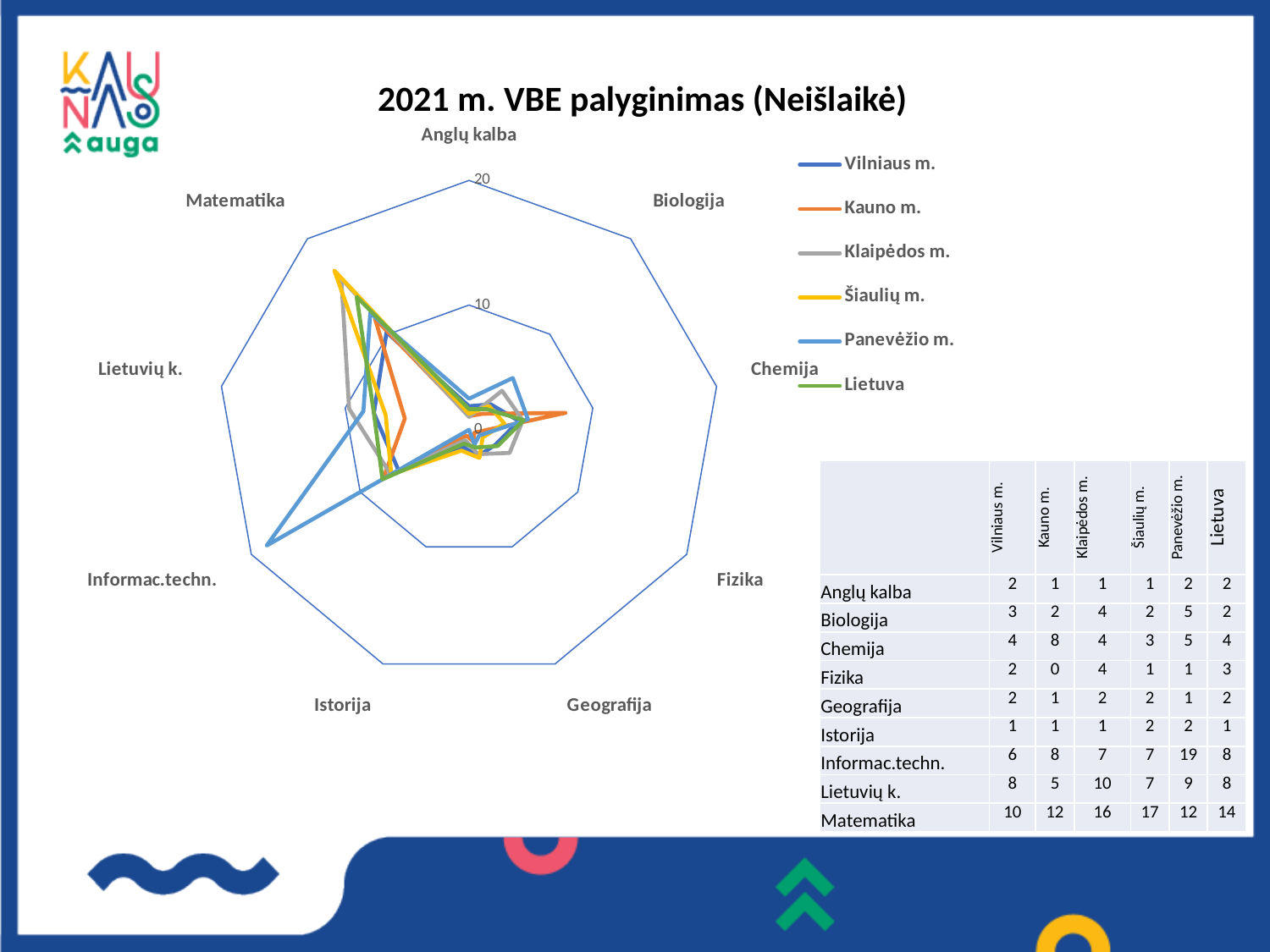
Is the value for Panevėžio m. in Informac.techn. greater or less than 10? greater What is the difference between the Panevėžio m. and Vilniaus m. values for Informac.techn.? 13 What is the title of the chart? 2021 m. VBE palyginimas (Neišlaikė) Which is larger for Chemija: the value for Kauno m. or for Vilniaus m.? Kauno m. What is the value for Panevėžio m. in Informac.techn.? 19 How many series does the legend list? 6 How many subject categories are plotted on the radar chart? 9 Which subject has the highest value for Šiaulių m.? Matematika Which subject has the highest value for Panevėžio m.? Informac.techn. What is the value for Šiaulių m. in Matematika? 17 What is the value for Kauno m. in Fizika? 0 What kind of chart is shown on the slide? Radar chart